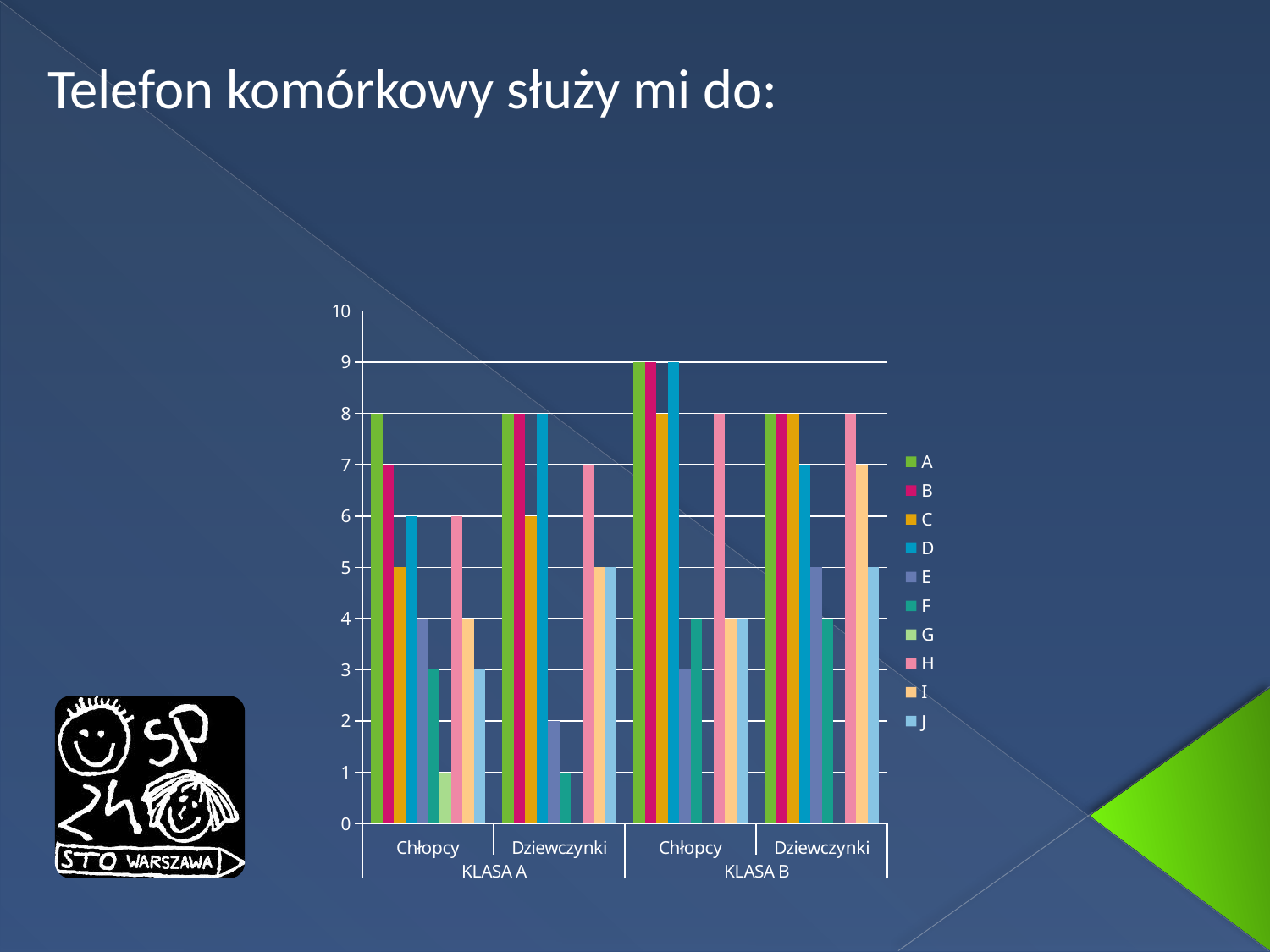
How many category groups are shown along the x axis? 4 What is the difference between series A for Chłopcy in KLASA B and series A for Chłopcy in KLASA A? 1 Is the value of series E for Chłopcy in KLASA B greater or less than 5? less What is the value of series G for Chłopcy in KLASA A? 1 What kind of chart is shown on the slide? bar chart What is the value of series A for Chłopcy in KLASA B? 9 What is the value of series H for Dziewczynki in KLASA A? 7 What is the title of the slide containing the chart? Telefon komórkowy służy mi do: How many series does the legend list? 10 Which series has the lowest value for Dziewczynki in KLASA A among the visible bars? F Which is larger for Chłopcy in KLASA A: series B or series C? B What is the value of series A for Chłopcy in KLASA A? 8